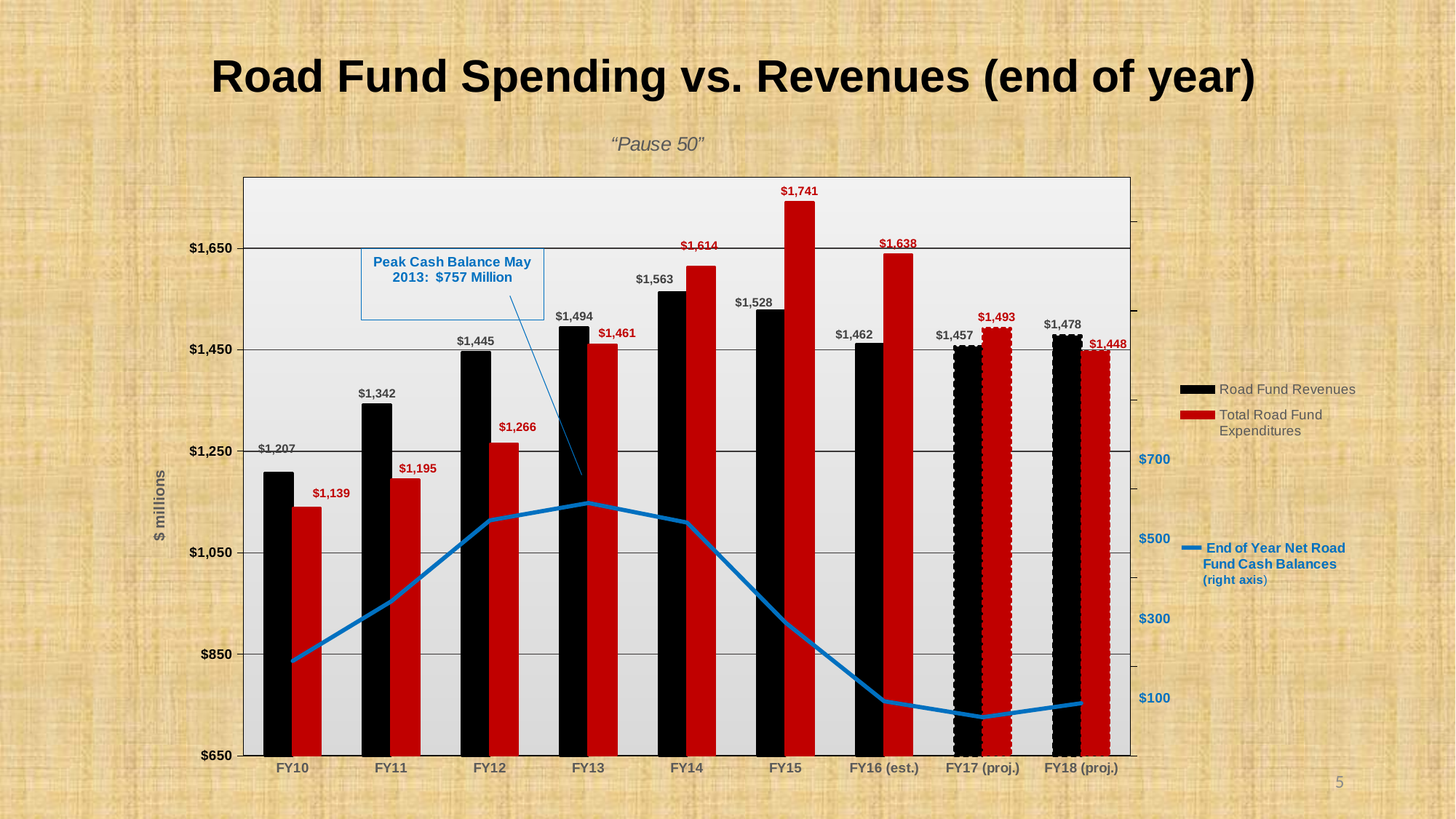
Is the End of Year Net Road Fund Cash Balance for FY13 greater or less than $500 on the right axis? greater Do Road Fund Revenues rise or fall from FY10 to FY14? rise What is the Total Road Fund Expenditures value for FY15? $1,741 In which fiscal year are Road Fund Revenues lowest? FY10 According to the annotation, what was the peak cash balance in May 2013? $757 Million In which fiscal year are Total Road Fund Expenditures highest? FY15 In FY13, which is larger: Road Fund Revenues or Total Road Fund Expenditures? Road Fund Revenues How many series does the legend list? 3 By how much do Total Road Fund Expenditures exceed Road Fund Revenues in FY15? $213 How many fiscal years are shown on the x axis? 9 Is the End of Year Net Road Fund Cash Balance for FY16 (est.) greater or less than $300 on the right axis? less What is the Road Fund Revenues value for FY14? $1,563